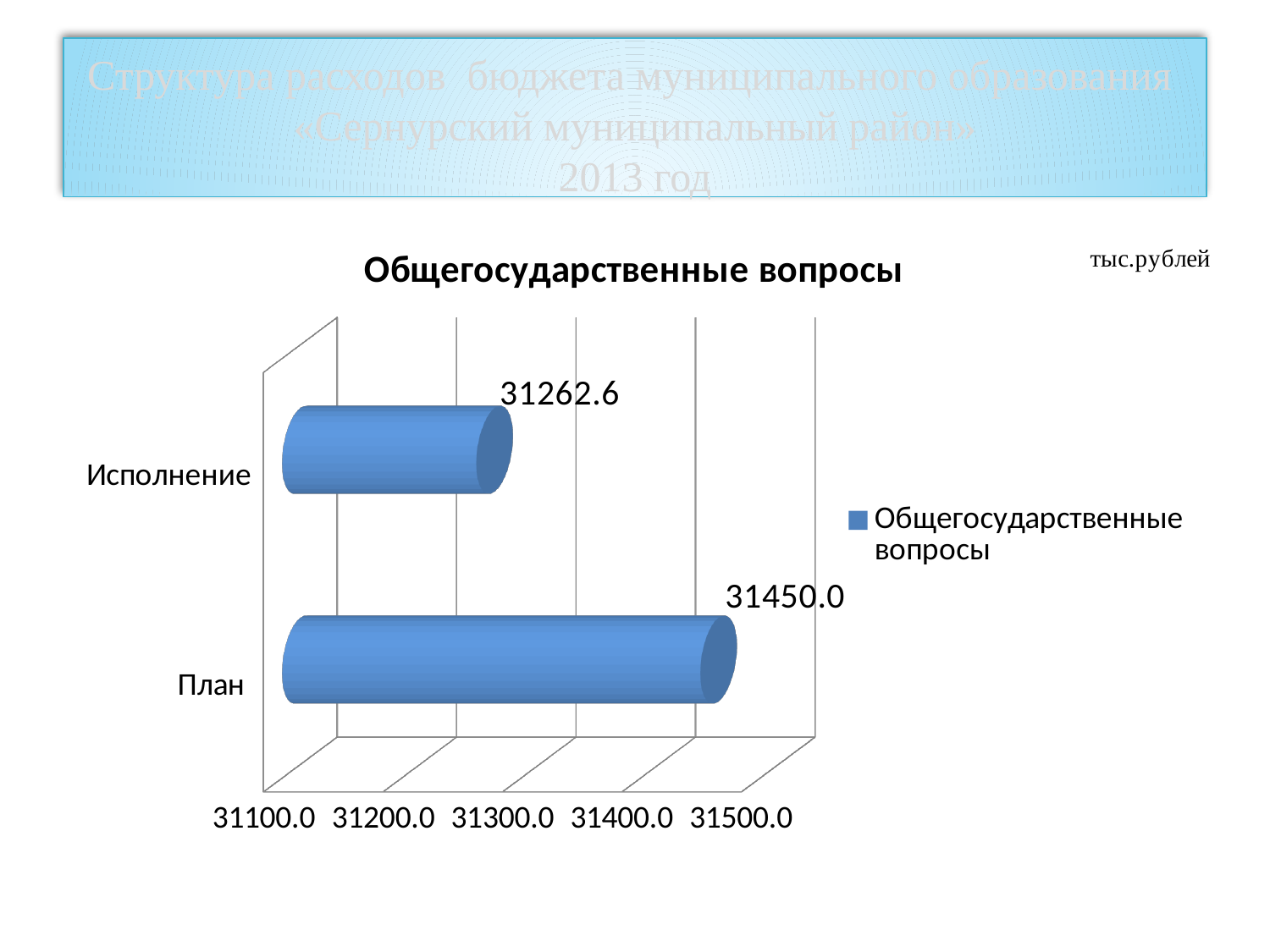
How many series does the legend list? 1 How many categories are shown in the chart? 2 What kind of chart is shown? bar chart Which category has the lowest value? Исполнение What is the difference between the values for План and Исполнение? 187.4 Which is larger, the value for План or the value for Исполнение? План What is the title of the chart? Общегосударственные вопросы What is the value for Исполнение? 31262.6 Is the value for Исполнение greater or less than 31300.0? less Which category has the highest value? План What is the value for План? 31450.0 Is the value for План greater or less than 31400.0? greater